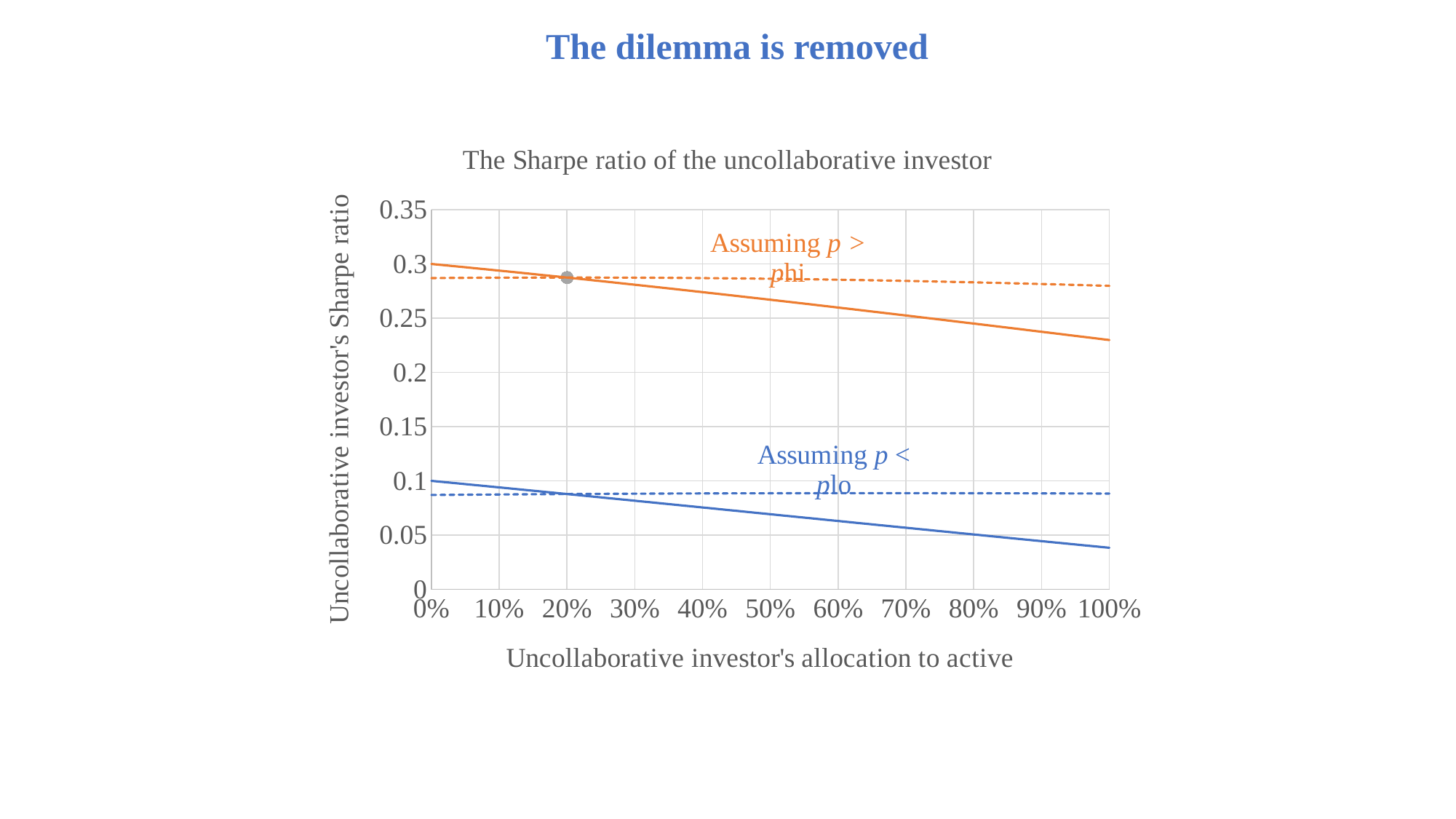
What is the value of the solid orange line (Assuming p > phi) at a 0% allocation to active? 0.3 Is the dashed blue line greater or less than 0.1 across the chart? less What is the label of the x axis? Uncollaborative investor's allocation to active What is the value of the solid blue line (Assuming p < plo) at a 0% allocation to active? 0.1 Does the solid blue line (Assuming p < plo) rise or fall as the allocation to active increases from 0% to 100%? fall Is the dashed orange line greater or less than 0.25 across the chart? greater Is the value of the solid blue line (Assuming p < plo) at a 100% allocation to active greater or less than 0.05? less What is the title of the chart? The Sharpe ratio of the uncollaborative investor At a 50% allocation to active, which solid line is higher: the orange (Assuming p > phi) or the blue (Assuming p < plo)? orange (Assuming p > phi) What kind of chart is shown on the slide? line chart Does the solid orange line (Assuming p > phi) rise or fall as the allocation to active increases from 0% to 100%? fall